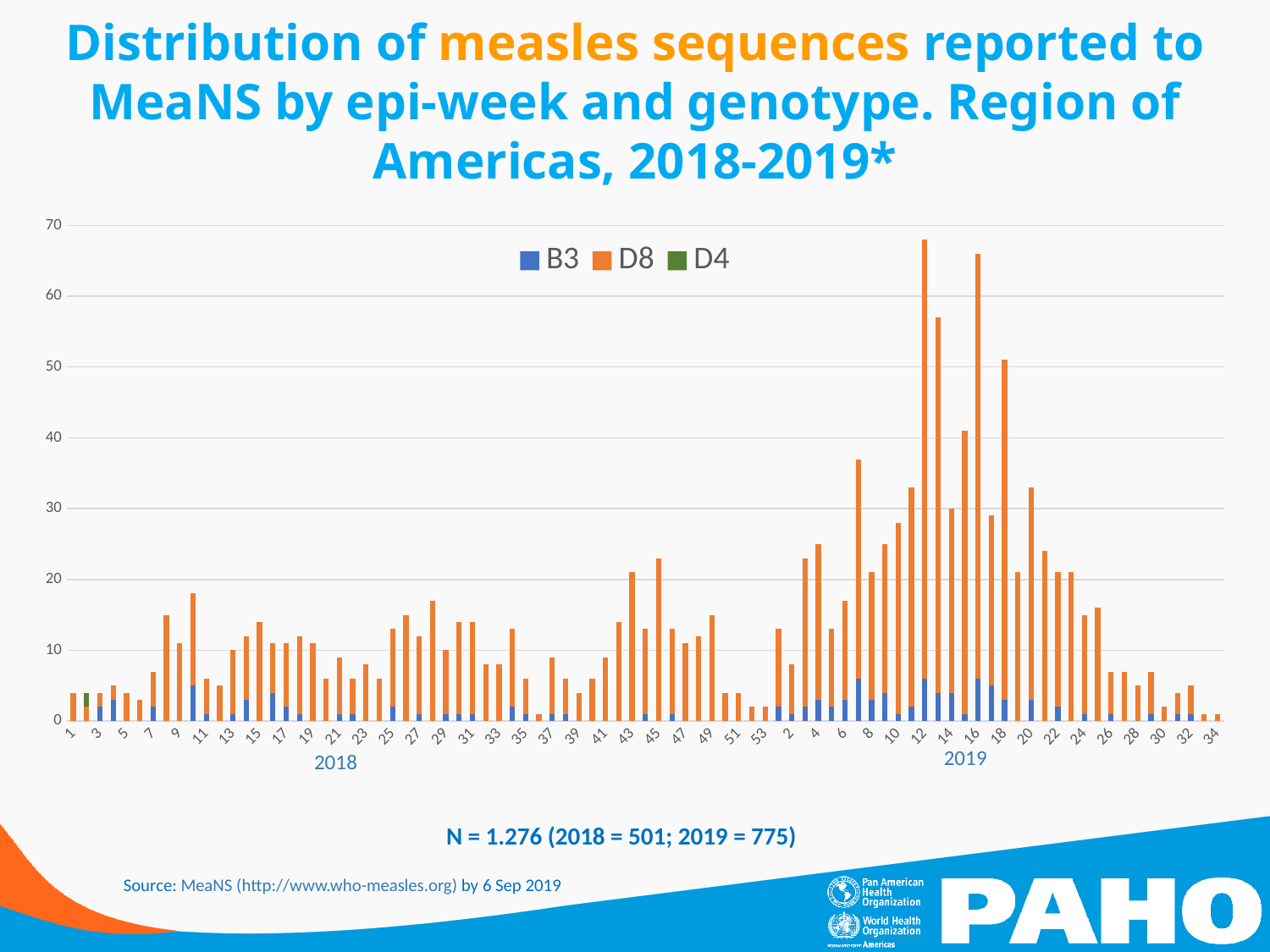
Which genotypes are listed in the legend? B3, D8, D4 What kind of chart is shown on the slide? Stacked bar chart Is the total for epi-week 13 of 2019 greater or less than 50? greater Which is larger: the total for epi-week 12 of 2019 or the total for epi-week 10 of 2018? Epi-week 12 of 2019 Is the total for epi-week 45 of 2018 greater or less than 20? greater Which epi-week has the highest total number of sequences? Week 12 of 2019 Is the total for epi-week 10 of 2018 greater or less than 20? less Which colour represents genotype D8 in the chart? Orange Do the totals rise or fall from epi-week 12 of 2019 to epi-week 34 of 2019? Fall How many series does the legend list? 3